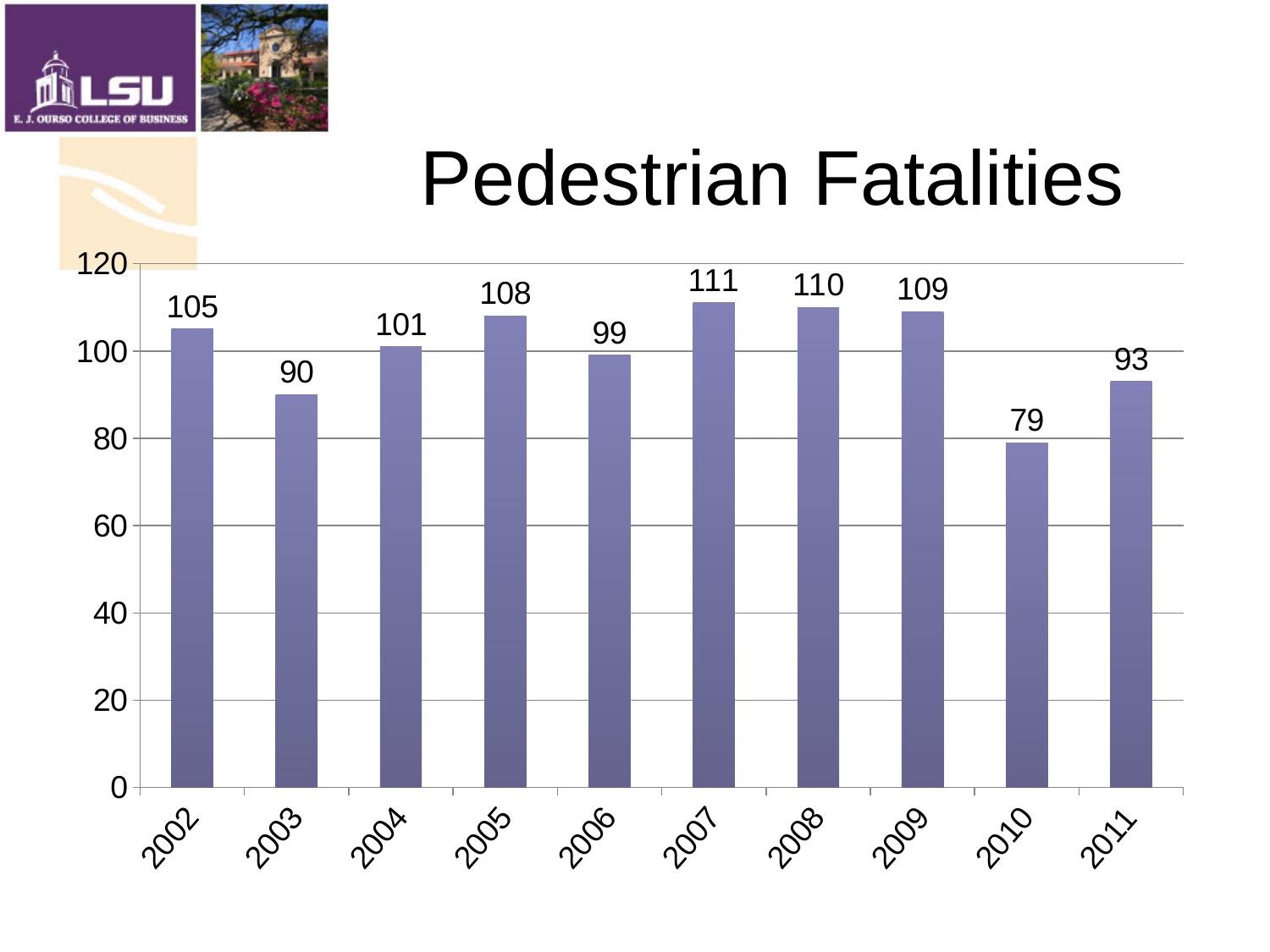
Do the values rise or fall from 2009 to 2010? fall Which year has the lowest value? 2010 How many years are shown on the x axis? 10 What is the difference between the values for 2007 and 2010? 32 What is the value for 2010? 79 Which year has the highest value? 2007 Is the value for 2006 greater or less than 100? less What is the title of the chart? Pedestrian Fatalities What kind of chart is this? bar chart What is the value for 2007? 111 Which is larger, the value for 2003 or the value for 2011? 2011 What is the value for 2002? 105